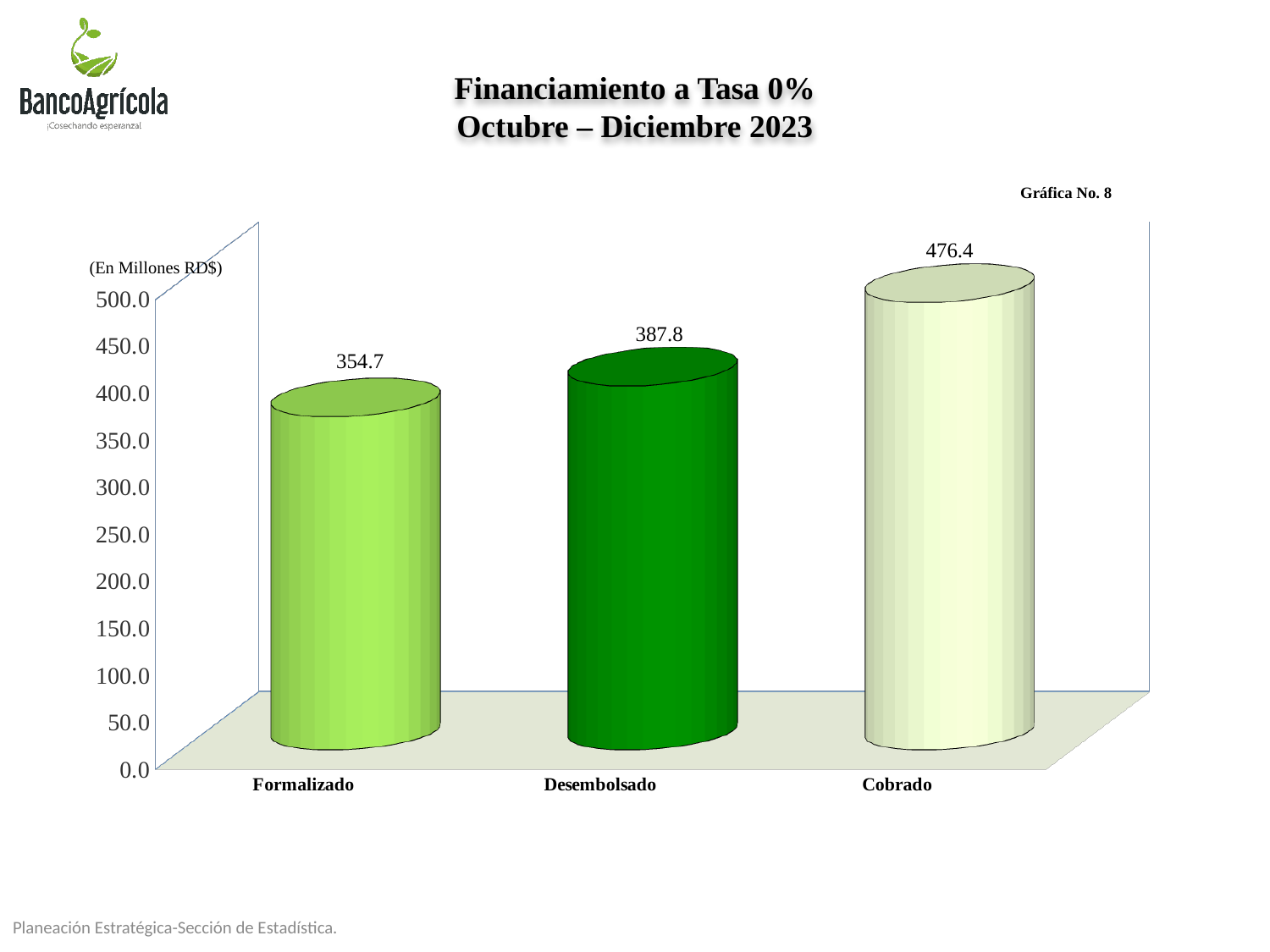
What unit is stated for the values on the chart? En Millones RD$ What is the value for Formalizado? 354.7 What is the difference between the values for Desembolsado and Formalizado? 33.1 What kind of chart is shown on the slide? bar chart Which category has the highest value? Cobrado What is the value for Cobrado? 476.4 Which is larger, the value for Desembolsado or the value for Cobrado? Cobrado What is the difference between the values for Cobrado and Formalizado? 121.7 Is the value for Formalizado greater or less than 400.0? less Which category has the lowest value? Formalizado How many categories are shown on the chart? 3 What is the value for Desembolsado? 387.8